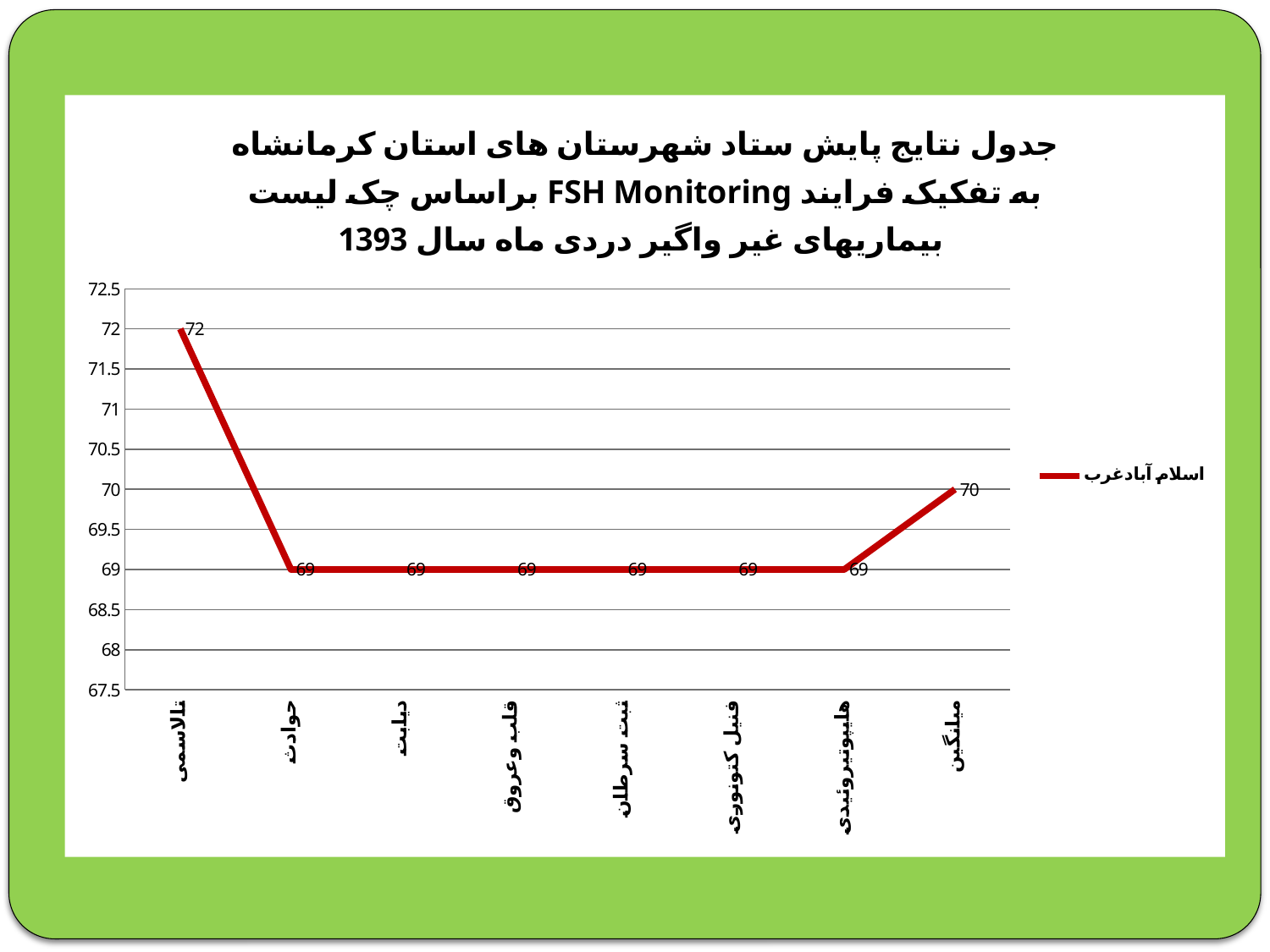
What is the value for تالاسمی? 72 How many series does the legend list? 1 What is the value for دیابت? 69 How many categories are plotted on the x axis? 8 What is the value for میانگین? 70 Which category has the highest value? تالاسمی What is the difference between the values for تالاسمی and میانگین? 2 Which is larger, the value for میانگین or the value for هیپوتیروئیدی? میانگین What is the difference between the values for تالاسمی and حوادث? 3 What kind of chart is shown on the slide? line chart What series name is shown in the legend? اسلام آبادغرب Is the value for تالاسمی greater or less than 71? greater